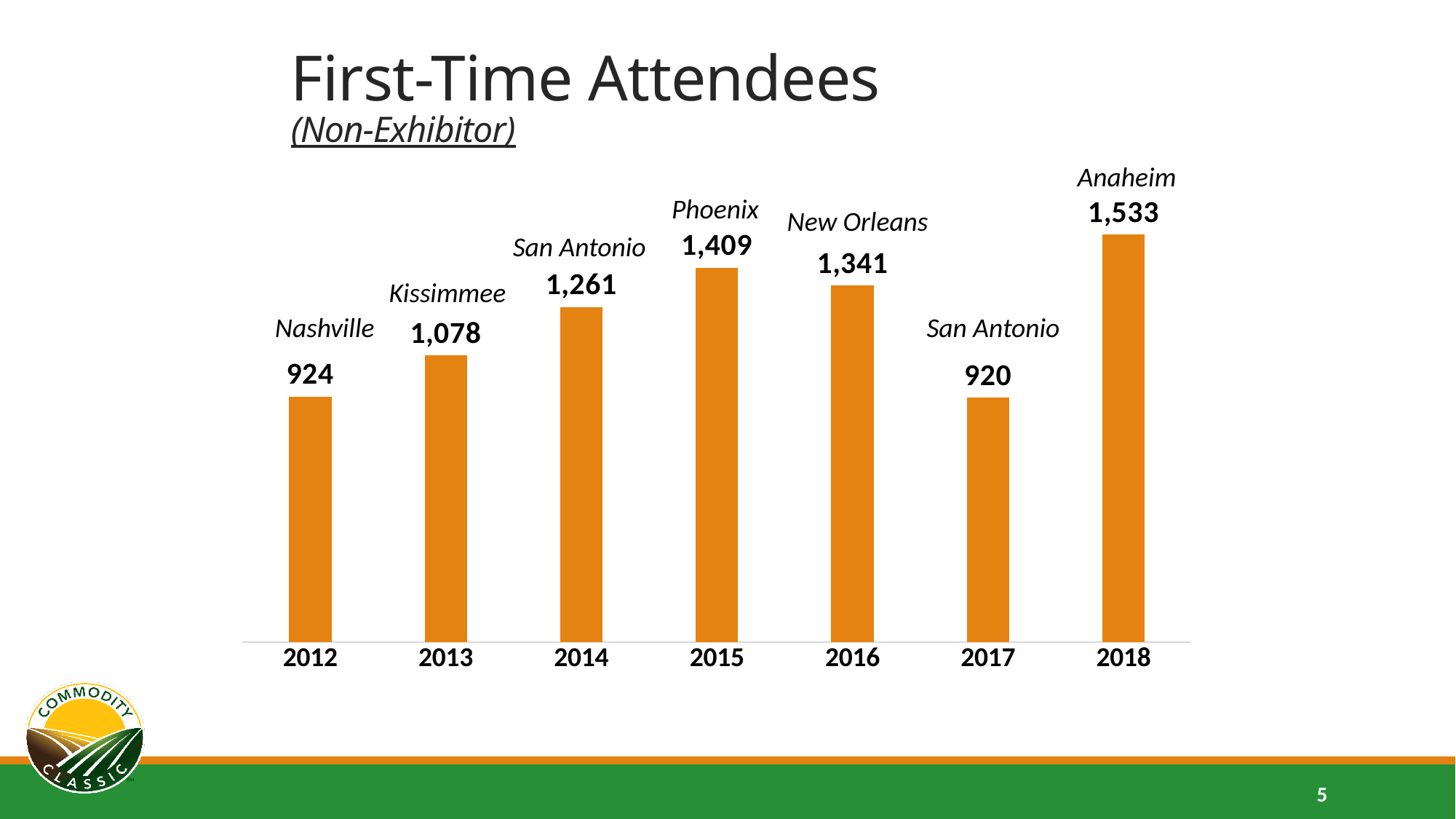
Which year has the lowest number of first-time attendees? 2017 Which year had more first-time attendees, 2015 or 2016? 2015 Which city hosted the event in 2018 according to the chart? Anaheim What is the number of first-time attendees in 2015? 1,409 What is the difference in first-time attendees between 2018 and 2017? 613 Which year has the highest number of first-time attendees? 2018 What kind of chart is shown on the slide? Bar chart Which city is labelled above the 2016 bar? New Orleans How many years are shown on the chart? 7 What is the number of first-time attendees in 2017? 920 What is the difference in first-time attendees between 2014 and 2013? 183 What is the number of first-time attendees in 2012? 924